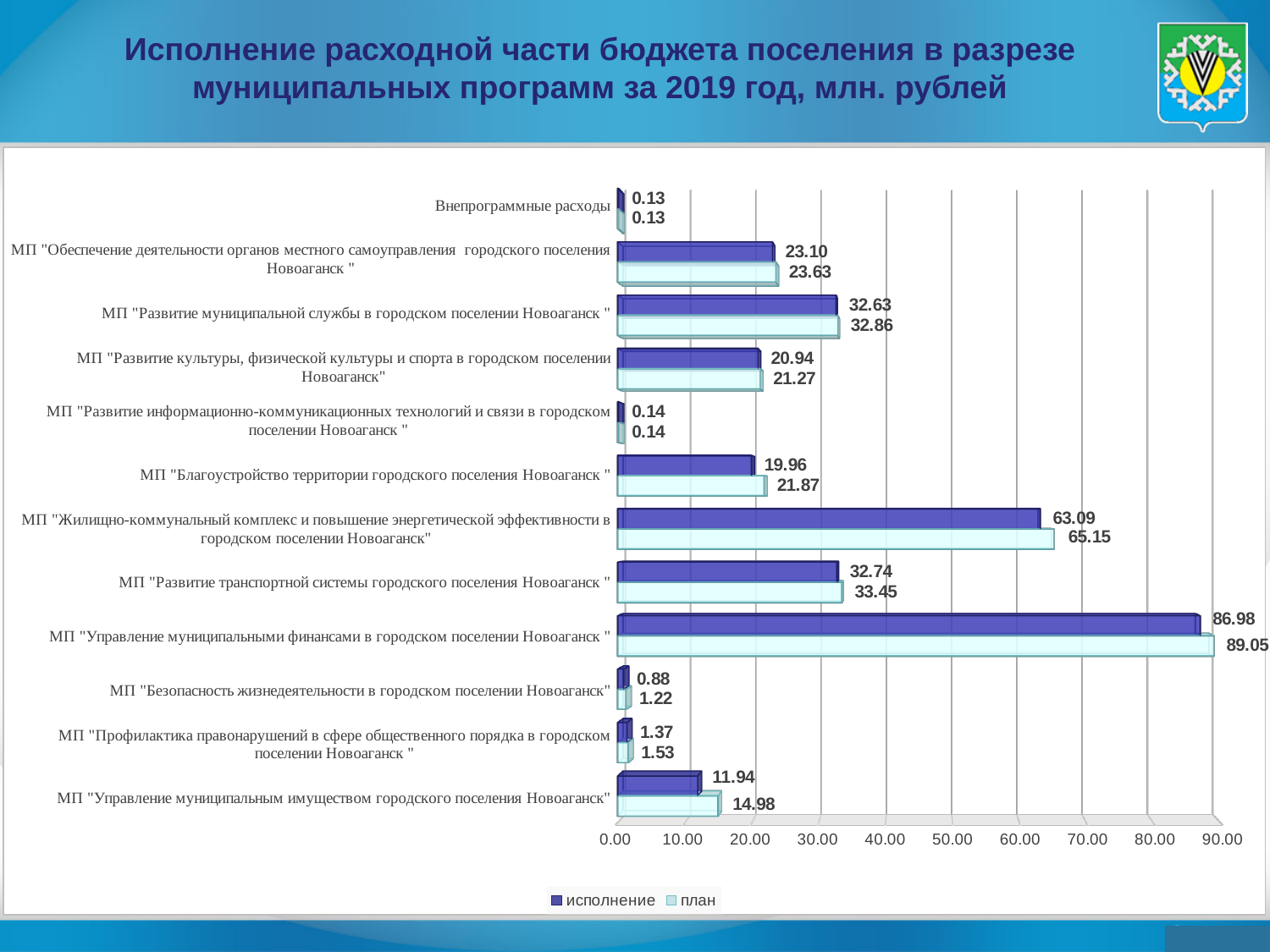
What is the difference between the план and исполнение values for МП "Управление муниципальными финансами в городском поселении Новоаганск"? 2.07 How many series does the legend list? 2 How many categories are plotted on the chart? 12 Which is larger: the исполнение value for МП "Развитие транспортной системы городского поселения Новоаганск" or the исполнение value for МП "Развитие муниципальной службы в городском поселении Новоаганск"? МП "Развитие транспортной системы городского поселения Новоаганск" Which category has the highest исполнение value? МП "Управление муниципальными финансами в городском поселении Новоаганск" What is the план value for МП "Жилищно-коммунальный комплекс и повышение энергетической эффективности в городском поселении Новоаганск"? 65.15 Which category has the lowest план value? Внепрограммные расходы What is the план value for МП "Управление муниципальным имуществом городского поселения Новоаганск"? 14.98 What is the исполнение value for МП "Управление муниципальными финансами в городском поселении Новоаганск"? 86.98 What type of chart is shown on the slide? bar chart What colour are the bars for the план series? light cyan Is the план value for МП "Благоустройство территории городского поселения Новоаганск" greater or less than 20.00? greater